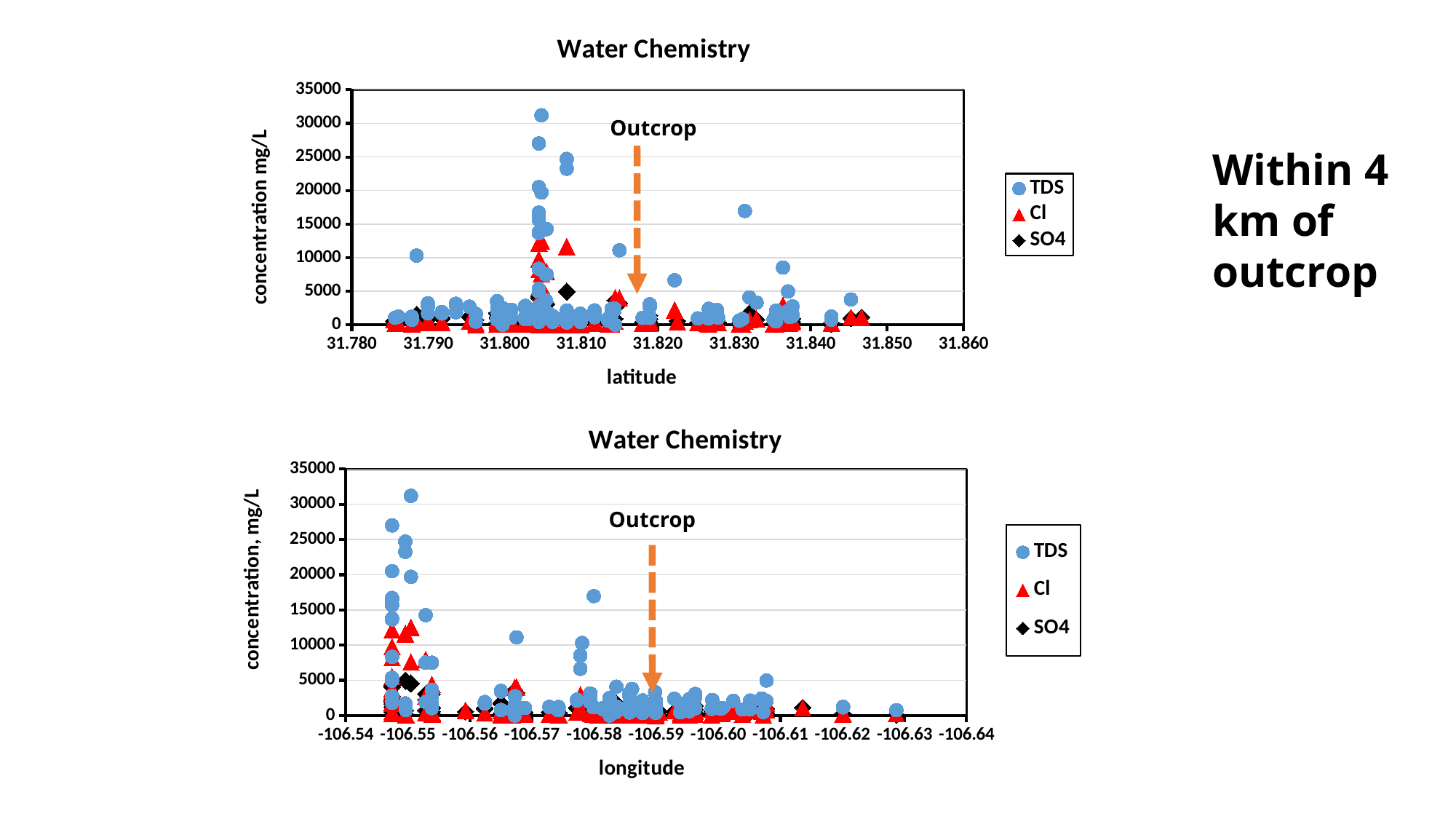
How many series does the legend of the top chart list? 3 What is the x-axis label of the bottom chart? longitude In the bottom chart, which series reaches the highest concentration? TDS What kind of chart is the bottom chart on the slide? scatter chart In the bottom chart, which series has a higher maximum value, TDS or SO4? TDS What kind of chart is the top chart on the slide? scatter chart In the bottom chart, is the highest Cl value greater or less than 15000? less How many series does the legend of the bottom chart list? 3 In the top chart, is the highest SO4 value greater or less than 10000? less What is the title of the top chart? Water Chemistry In the top chart, which series reaches the highest concentration? TDS In the top chart, is the highest TDS value greater or less than 30000? greater